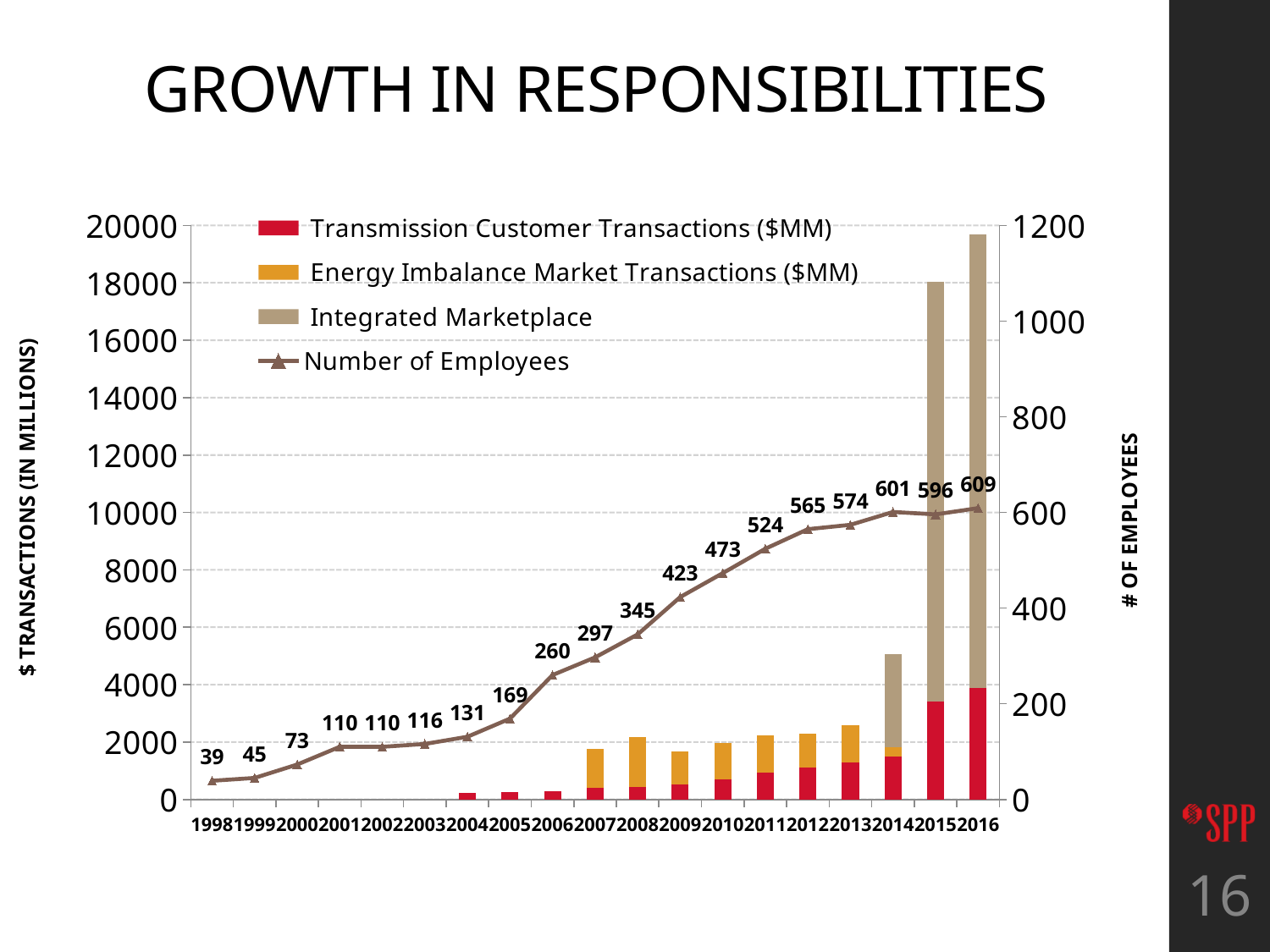
Does the Number of Employees generally rise or fall from 1998 to 2016? Rise What is the Number of Employees in 2016? 609 What is the Number of Employees in 1998? 39 How many series does the legend list? 4 Which year has more employees, 2014 or 2015? 2014 What is the Number of Employees in 2010? 473 In which year is the Number of Employees lowest? 1998 What kind of chart is this? A stacked bar chart combined with a line chart In which year is the Number of Employees highest? 2016 By how much did the Number of Employees increase from 1998 to 2016? 570 Is the total height of the stacked bar for 2016 greater or less than 18000? greater How many years are shown on the x axis? 19